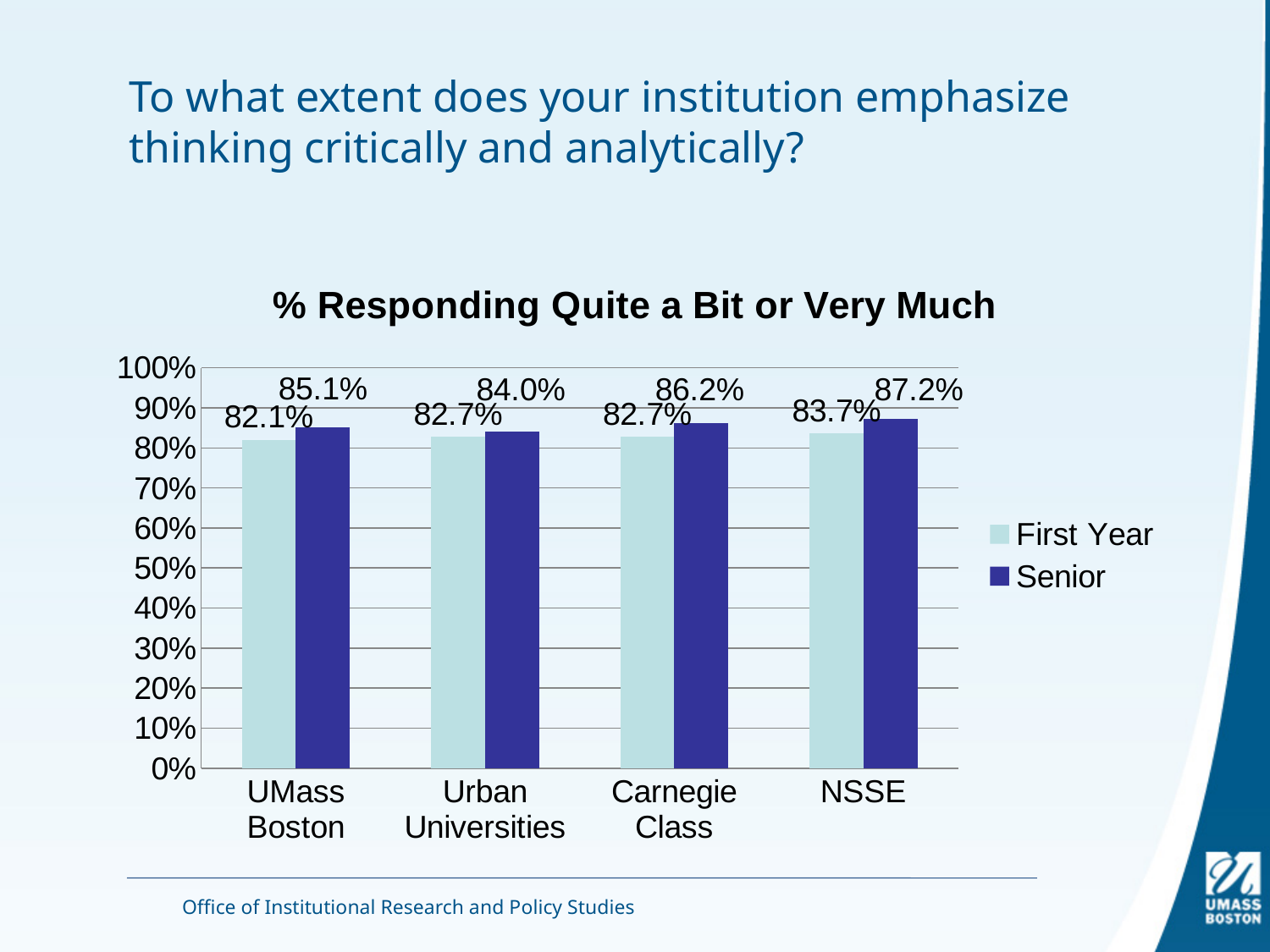
Is the First Year value for NSSE greater or less than 90%? less What is the difference between the Senior and First Year values for Carnegie Class? 3.5% What is the Senior value for Urban Universities? 84.0% Which category has the lowest First Year value? UMass Boston What is the Senior value for NSSE? 87.2% How many categories are shown on the x axis? 4 What is the First Year value for UMass Boston? 82.1% What is the title of the chart? % Responding Quite a Bit or Very Much Which category has the highest Senior value? NSSE How many series does the legend list? 2 What kind of chart is shown? bar chart Which is larger for UMass Boston, the First Year value or the Senior value? Senior